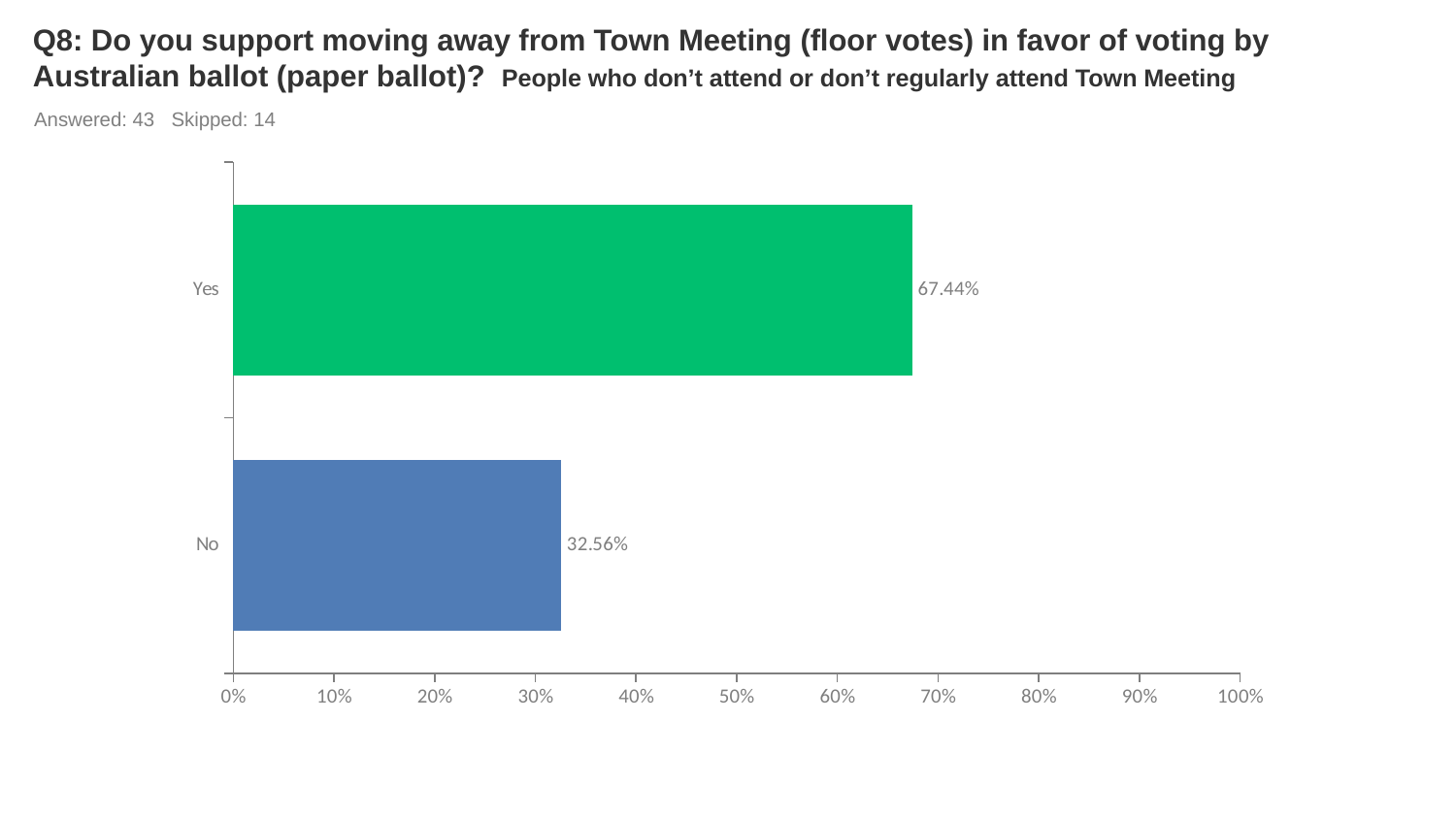
What kind of chart is shown on the slide? Bar chart Which is larger, the value for Yes or the value for No? Yes How many people answered this question according to the slide? 43 Is the value for No greater or less than 40%? less What is the maximum value shown on the horizontal axis? 100% What percentage of respondents answered Yes? 67.44% How many response categories are shown in the chart? 2 What is the difference between the Yes and No percentages? 34.88% Which response category has the lowest value? No Is the value for Yes greater or less than 60%? greater What percentage of respondents answered No? 32.56% Which response category has the highest value? Yes